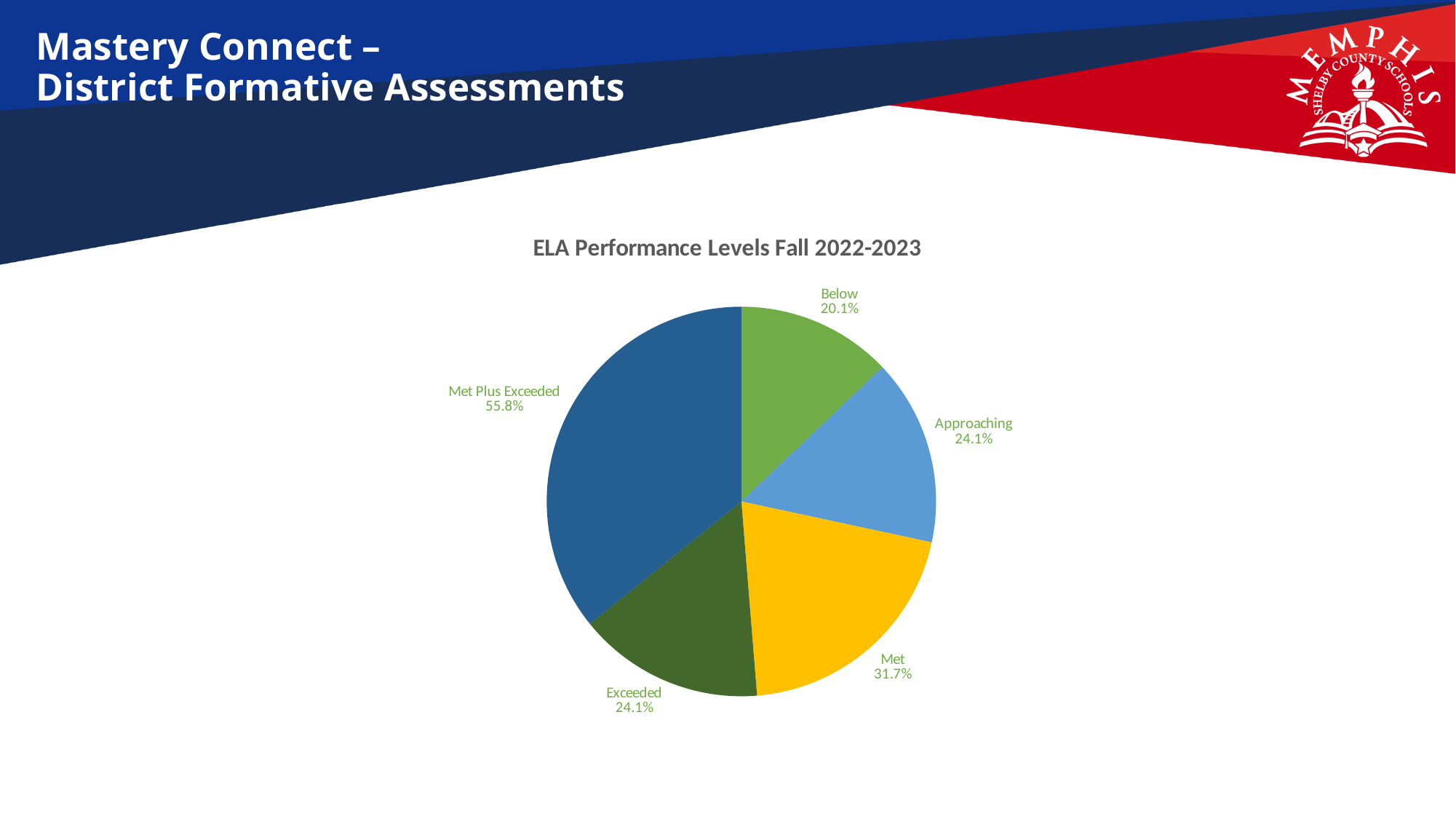
Which is larger, the Met slice or the Approaching slice? Met What is the title of the chart? ELA Performance Levels Fall 2022-2023 What share of the pie is labelled Met Plus Exceeded? 55.8% What percentage is shown for the Below slice? 20.1% What percentage is shown for the Approaching slice? 24.1% What kind of chart is shown on the slide? pie chart Which slice has the smallest percentage? Below Which slice has the largest percentage? Met Plus Exceeded What percentage is shown for the Met slice? 31.7% How many slices does the pie chart have? 5 What percentage is shown for the Exceeded slice? 24.1% What is the difference between the Met percentage and the Below percentage? 11.6%